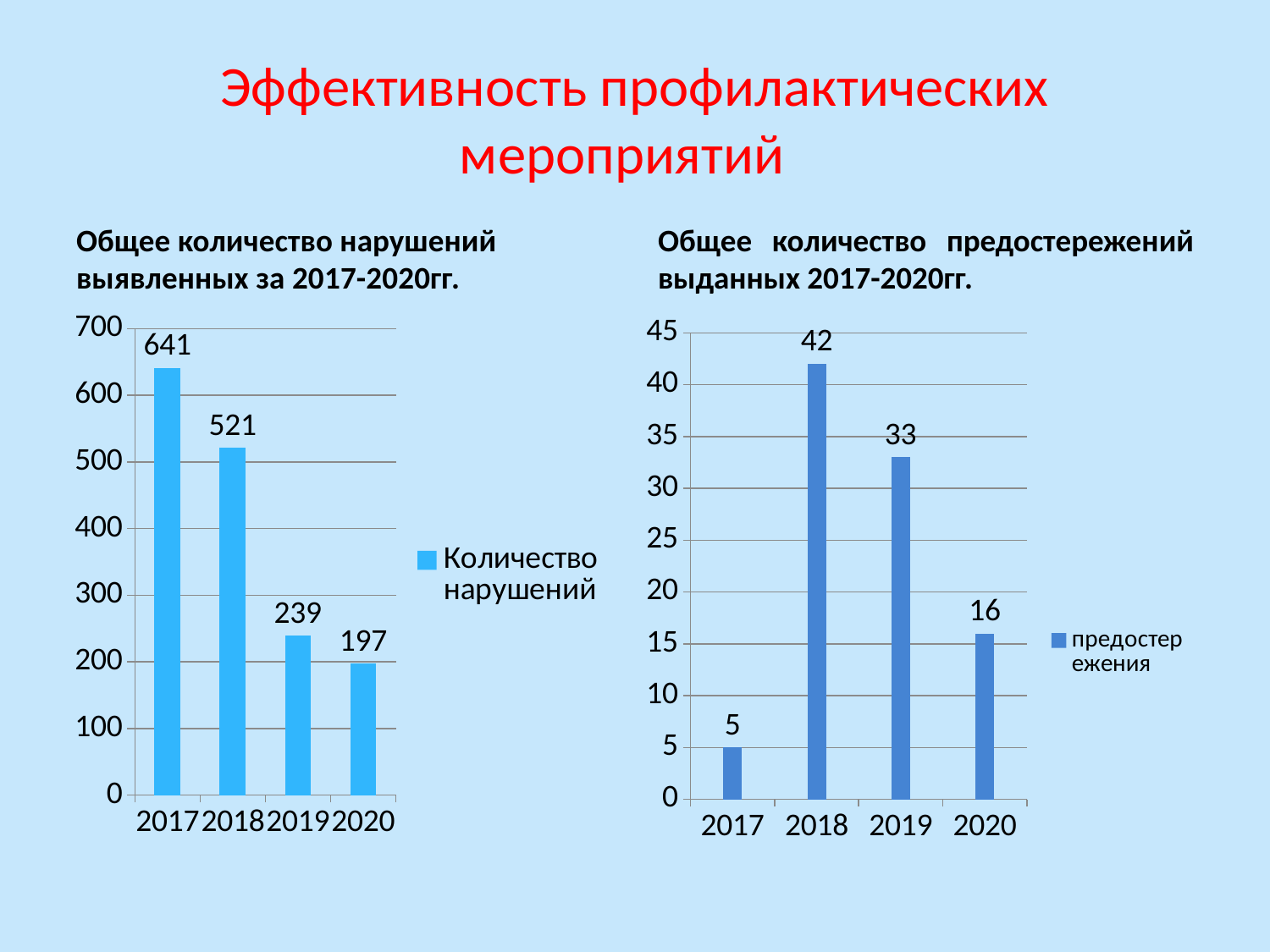
In the right chart (Общее количество предостережений выданных 2017-2020гг.), which is larger, the value for 2019 or the value for 2020? 2019 In the left chart (Общее количество нарушений выявленных за 2017-2020гг.), which year has the lowest value? 2020 In the left chart (Общее количество нарушений выявленных за 2017-2020гг.), what is the difference between the values for 2017 and 2018? 120 In the right chart (Общее количество предостережений выданных 2017-2020гг.), what is the difference between the values for 2018 and 2019? 9 In the left chart (Общее количество нарушений выявленных за 2017-2020гг.), do the values rise or fall from 2017 to 2020? fall In the left chart (Общее количество нарушений выявленных за 2017-2020гг.), what is the value for 2017? 641 In the right chart (Общее количество предостережений выданных 2017-2020гг.), what is the value for 2018? 42 In the left chart (Общее количество нарушений выявленных за 2017-2020гг.), how many years are shown on the x axis? 4 In the left chart (Общее количество нарушений выявленных за 2017-2020гг.), what is the value for 2020? 197 What kind of chart is the right chart (Общее количество предостережений выданных 2017-2020гг.)? bar chart In the right chart (Общее количество предостережений выданных 2017-2020гг.), what is the value for 2017? 5 In the right chart (Общее количество предостережений выданных 2017-2020гг.), which year has the highest value? 2018